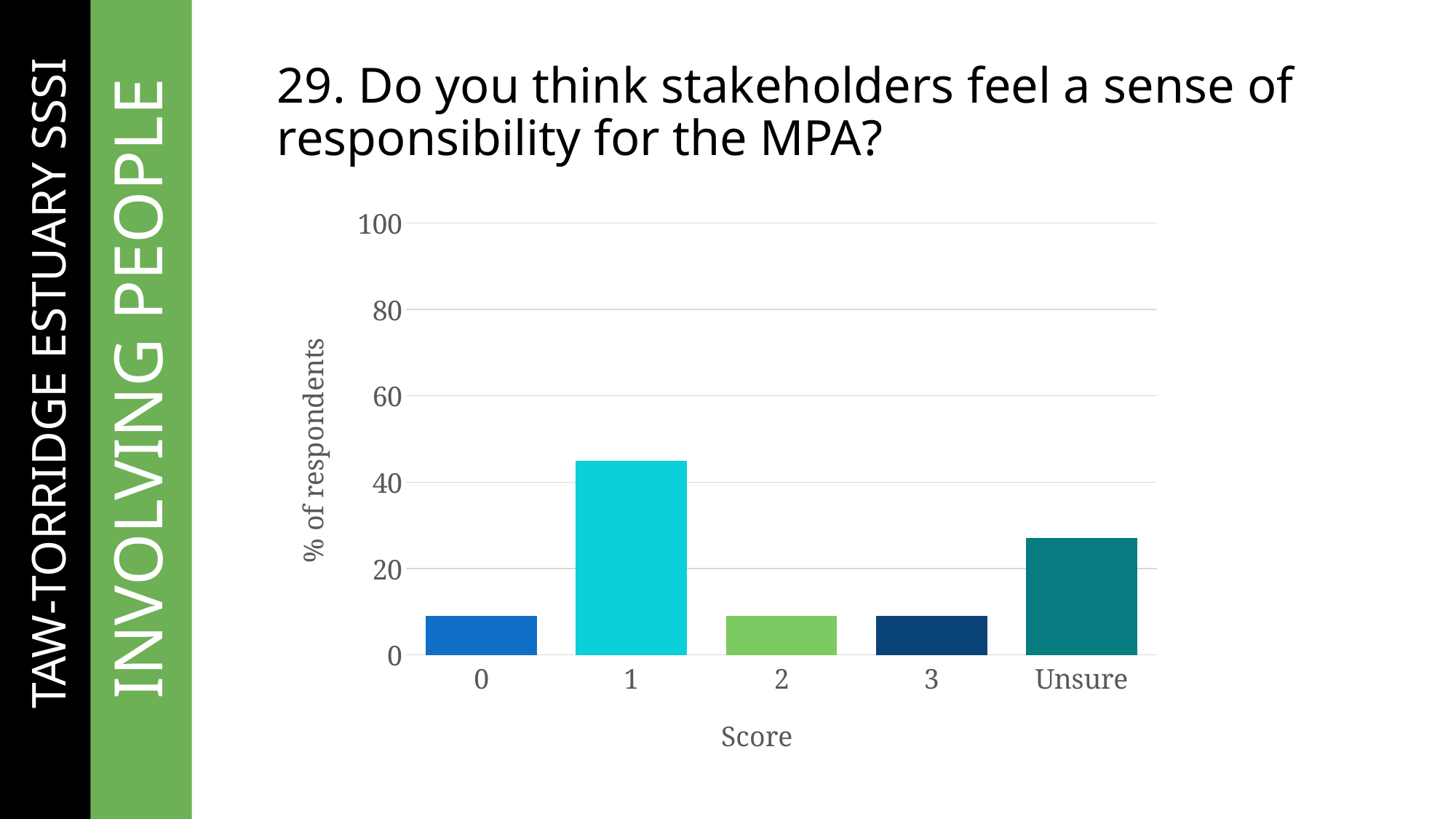
Is the value for score 0 greater or less than 20? less Which score category has the highest percentage of respondents? 1 Is the value for Unsure greater or less than 40? less Is the value for score 1 greater or less than 40? greater What type of chart is shown on the slide? bar chart What is the label on the x axis? Score Which is larger, the value for score 1 or the value for Unsure? 1 How many categories are shown on the x axis? 5 Which is larger, the value for Unsure or the value for score 2? Unsure What is the label on the y axis? % of respondents